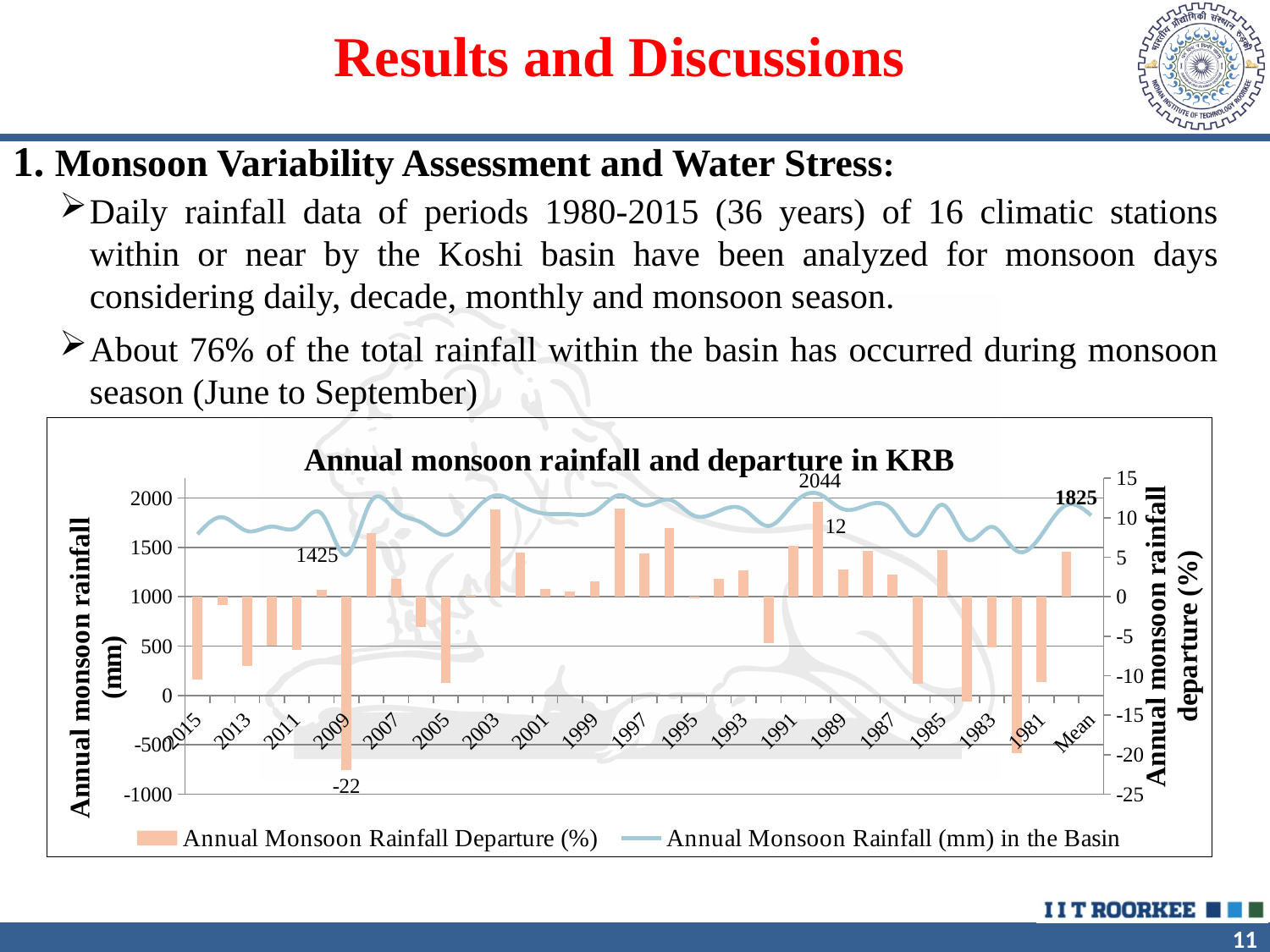
What is the difference between the highest labeled annual monsoon rainfall value (2044) and the 2009 value (1425)? 619 How many series does the chart legend list? 2 What is the title of the chart? Annual monsoon rainfall and departure in KRB What kind of chart is shown on the slide? Combined bar and line chart What is the annual monsoon rainfall (mm) value labeled for 2009? 1425 Which year has the lowest annual monsoon rainfall departure (%)? 2009 What is the highest annual monsoon rainfall (mm) value labeled on the line? 2044 Is the annual monsoon rainfall departure (%) for 2015 greater or less than 0? less Which is larger, the annual monsoon rainfall (mm) for 2009 or for Mean? Mean What is the largest annual monsoon rainfall departure (%) value labeled on the bars? 12 What is the annual monsoon rainfall departure (%) labeled for 2009? -22 What is the annual monsoon rainfall (mm) value labeled for Mean? 1825